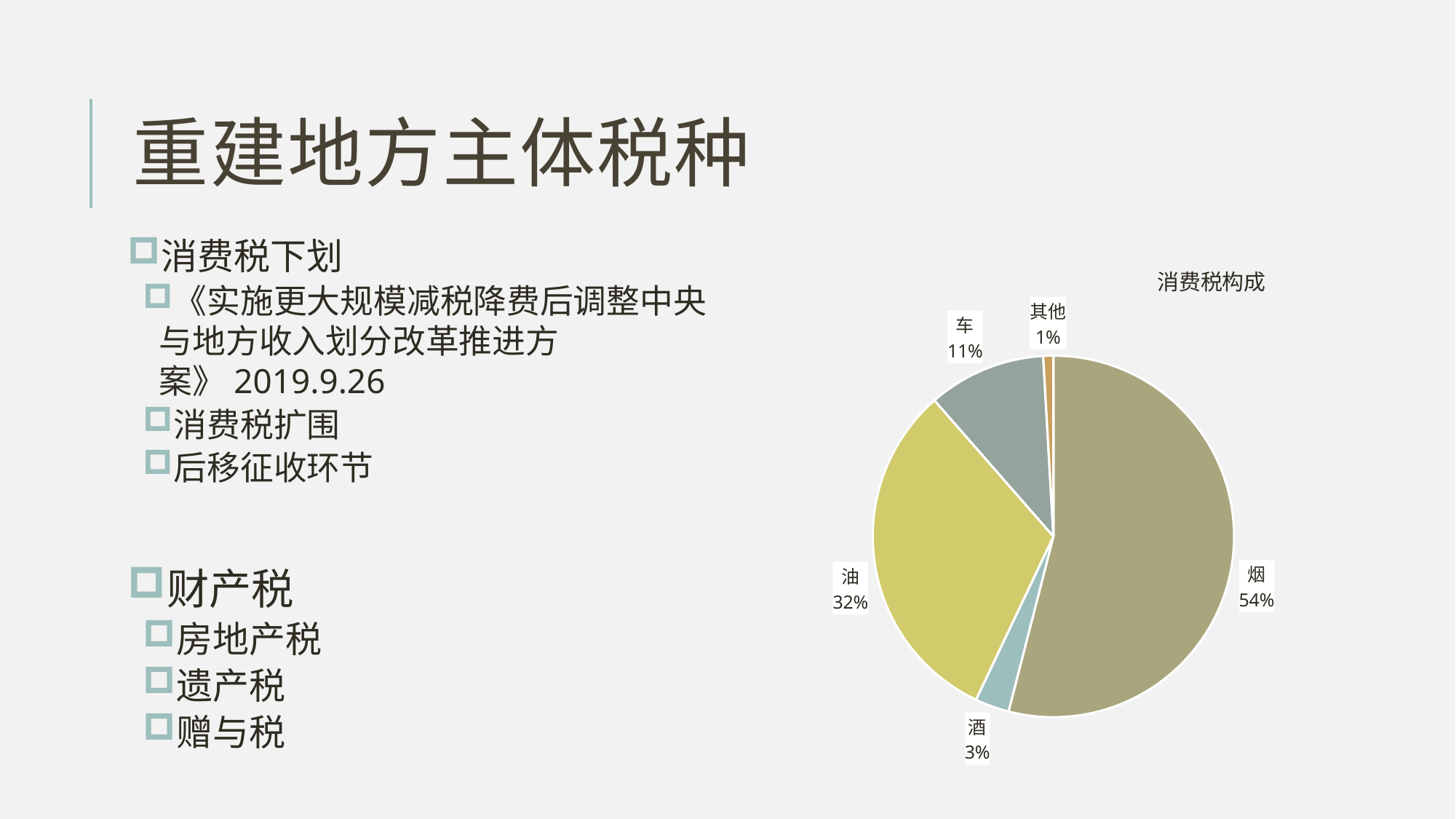
What is the value shown for 其他? 1% How many categories are shown in the pie chart? 5 What share of the pie does 烟 account for? 54% What is the title of the chart? 消费税构成 What share of the pie does 油 account for? 32% What is the value shown for 酒? 3% What is the value shown for 车? 11% What is the difference between the shares of 烟 and 油? 22% Which category has the largest slice of the pie? 烟 Which is larger, the share for 车 or the share for 酒? 车 Which category has the smallest slice of the pie? 其他 What kind of chart is shown on the slide? pie chart